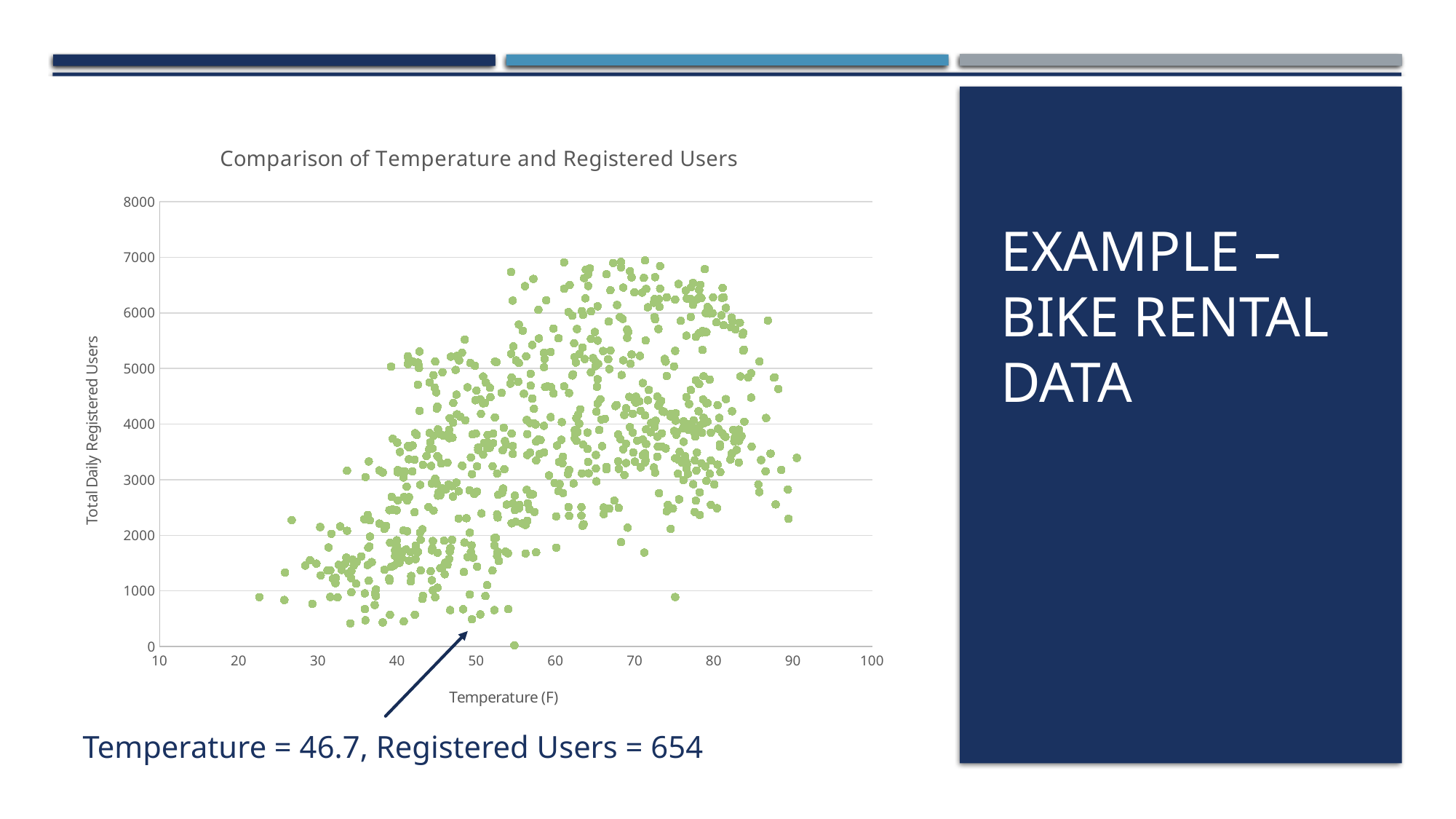
Is the temperature of the annotated point greater or less than 50? less What is the highest value shown on the y axis? 8000 What is the title of the chart? Comparison of Temperature and Registered Users Overall, do registered users tend to rise or fall as temperature increases along the x axis? rise What kind of chart is shown on the slide? scatter chart Are the points at temperatures below 30 F mostly above or below 3000 registered users? below What is the temperature of the point called out by the arrow annotation? 46.7 How many registered users does the annotated point have? 654 What is the label of the y axis? Total Daily Registered Users Is the registered users value for the annotated point (Temperature = 46.7) greater or less than 1000? less